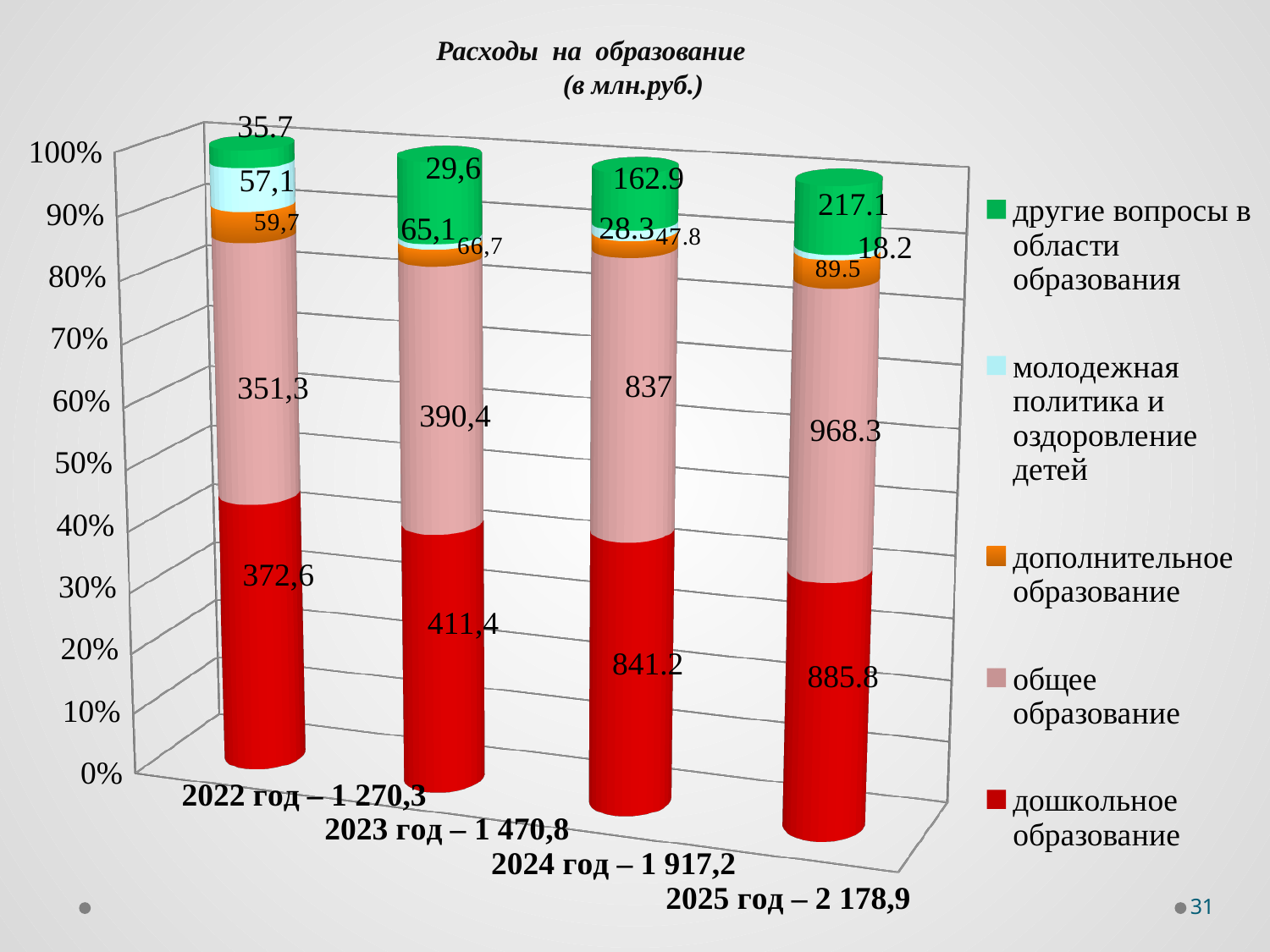
Which is larger in 2025 год: дошкольное образование or общее образование? общее образование What is the value for дошкольное образование in 2022 год? 372,6 What is the value for другие вопросы в области образования in 2024 год? 162.9 How many years are shown on the x axis? 4 Which year has the lowest value for молодежная политика и оздоровление детей? 2025 год What is the difference between the дошкольное образование values for 2025 год and 2024 год? 44.6 What kind of chart is shown on the slide? stacked bar chart How many series does the legend list? 5 What is the value for дополнительное образование in 2023 год? 66,7 What is the value for общее образование in 2025 год? 968.3 Which year has the highest value for другие вопросы в области образования? 2025 год What is the value for молодежная политика и оздоровление детей in 2025 год? 18.2